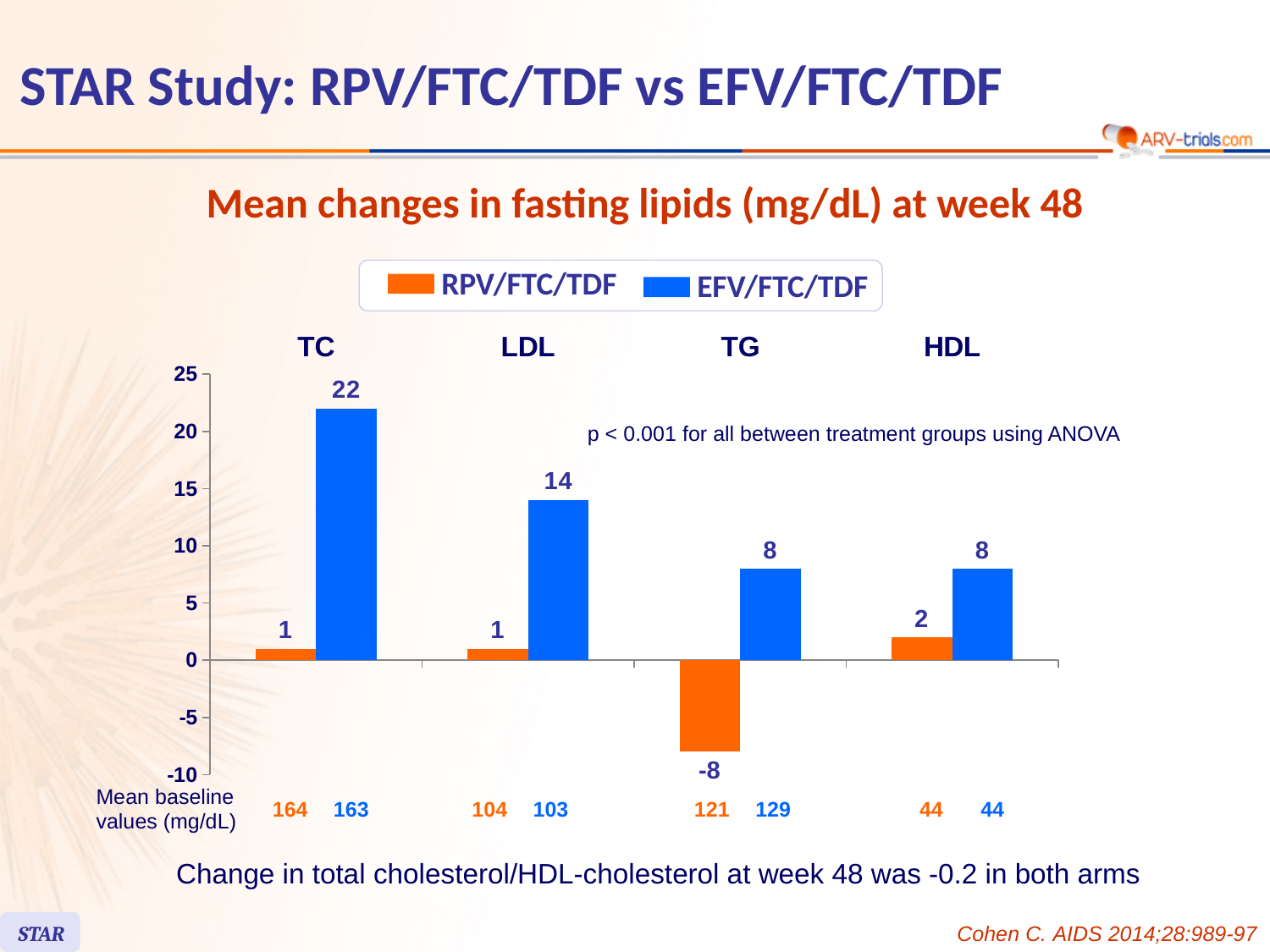
How many lipid parameters are shown on the chart? 4 Which lipid parameter shows the lowest mean change for the RPV/FTC/TDF arm? TG What is the mean change in LDL for the EFV/FTC/TDF arm? 14 What is the mean change in HDL for the RPV/FTC/TDF arm? 2 What kind of chart is shown on the slide? Bar chart What is the mean change in TG for the RPV/FTC/TDF arm? -8 What is the difference between the EFV/FTC/TDF and RPV/FTC/TDF mean changes in TC? 21 What is the mean change in TC for the EFV/FTC/TDF arm? 22 What is the difference between the EFV/FTC/TDF and RPV/FTC/TDF mean changes in TG? 16 How many series does the legend list? 2 Which arm has the larger mean change in LDL, RPV/FTC/TDF or EFV/FTC/TDF? EFV/FTC/TDF Which lipid parameter shows the highest mean change for the EFV/FTC/TDF arm? TC